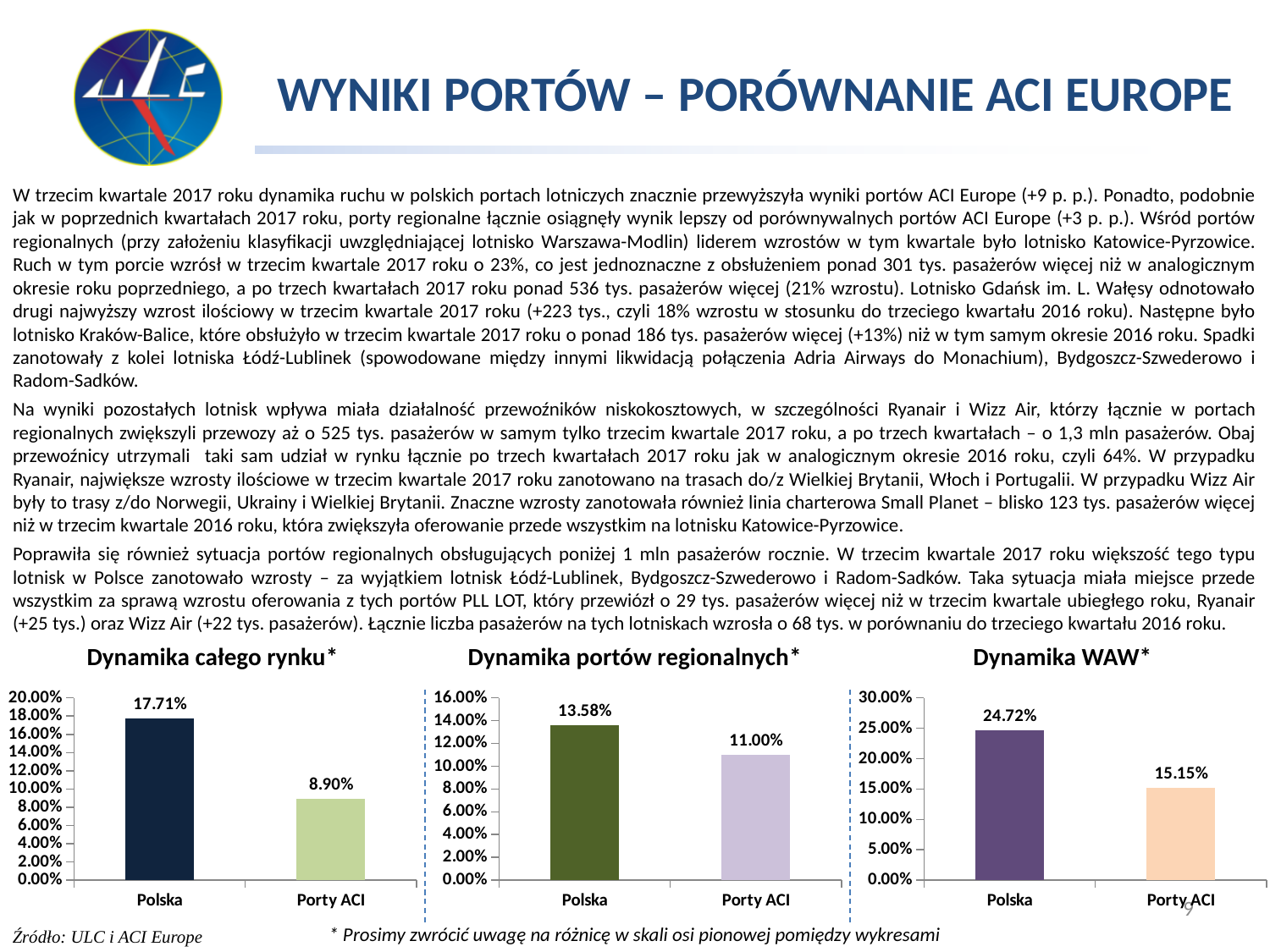
In the chart 'Dynamika całego rynku*', what is the difference between the values for Polska and Porty ACI? 8.81 percentage points In the chart 'Dynamika portów regionalnych*', what is the value for Porty ACI? 11.00% What type of chart is 'Dynamika WAW*'? Bar chart In the chart 'Dynamika całego rynku*', is the value for Polska greater or less than 16.00%? greater In the chart 'Dynamika portów regionalnych*', which category has the higher value? Polska How many charts are shown on the slide? 3 In the chart 'Dynamika WAW*', what is the value for Polska? 24.72% In the chart 'Dynamika WAW*', what is the value for Porty ACI? 15.15% How many bars does the chart 'Dynamika portów regionalnych*' show? 2 In the chart 'Dynamika całego rynku*', what is the value for Porty ACI? 8.90% In the chart 'Dynamika WAW*', what is the difference between the values for Polska and Porty ACI? 9.57 percentage points In the chart 'Dynamika całego rynku*', what is the value for Polska? 17.71%